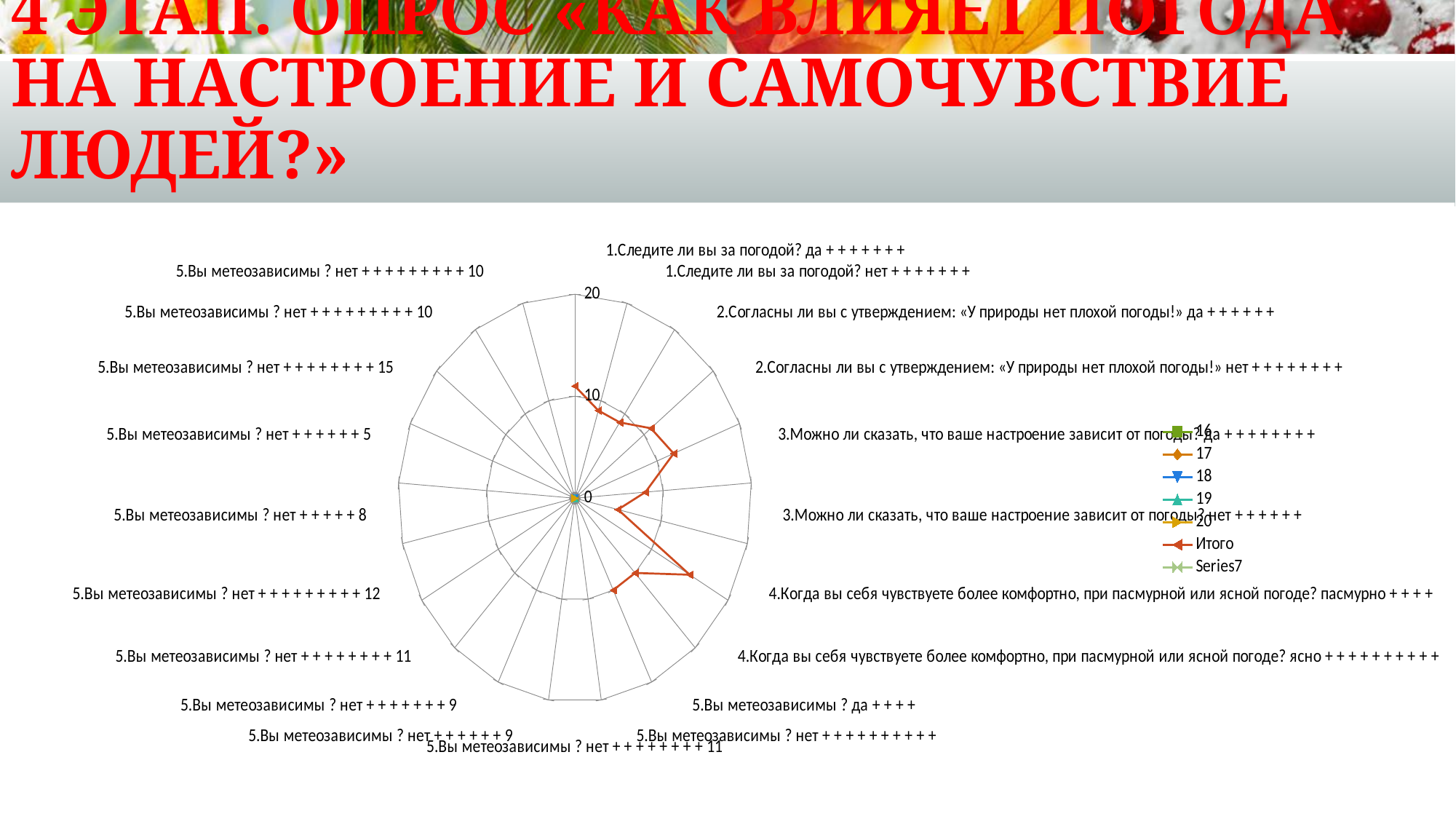
How many series does the chart legend list? 7 What is the highest value shown on the chart's radial axis? 20 Is the Итого value for "3.Можно ли сказать, что ваше настроение зависит от погоды? нет" greater or less than 10? less Is the Итого value for "4.Когда вы себя чувствуете более комфортно, при пасмурной или ясной погоде? пасмурно" greater or less than 20? less What kind of chart is shown on the slide? radar chart Which legend entry is drawn with the red-orange line on the chart? Итого